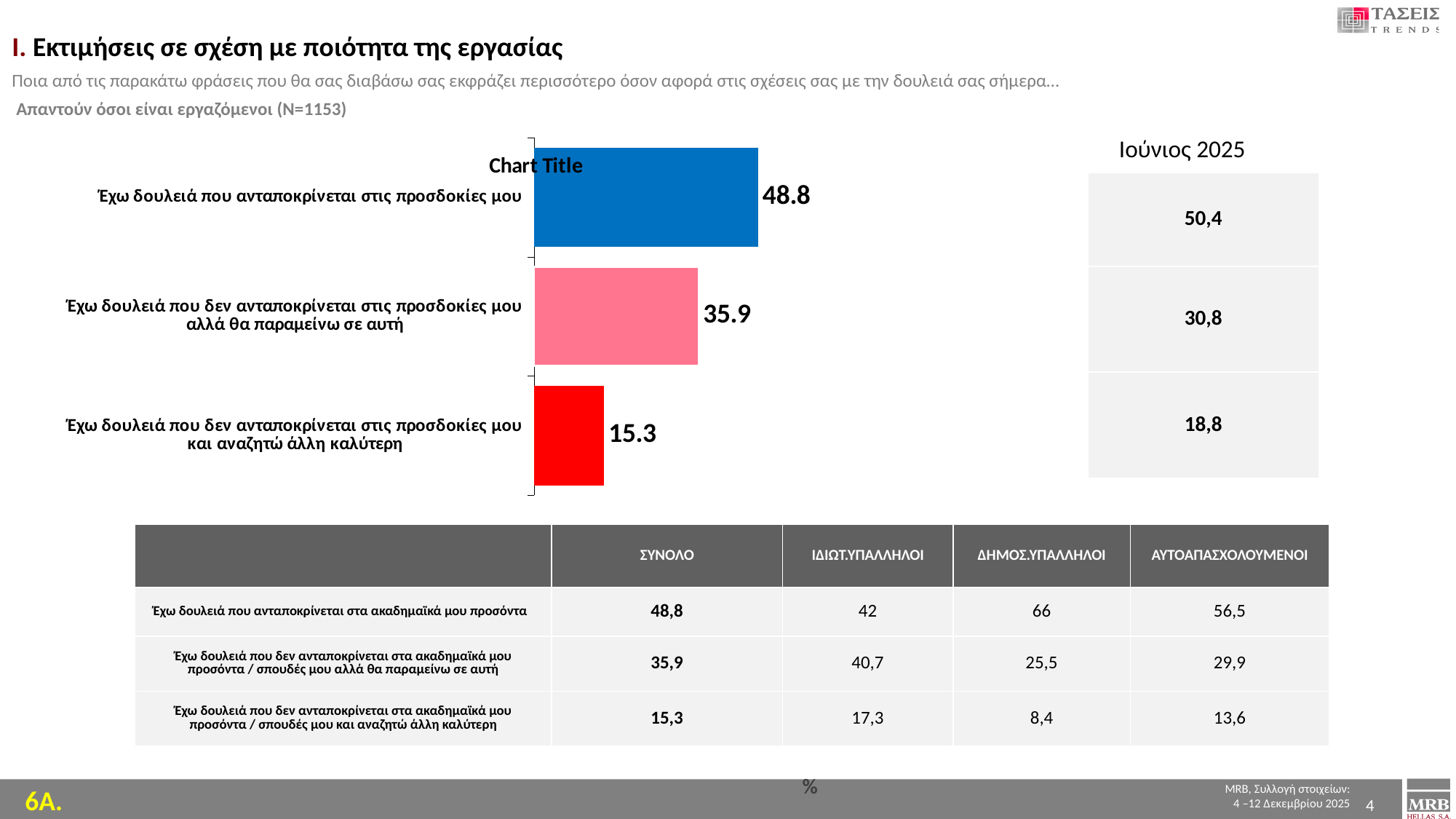
What is the difference between the value for "Έχω δουλειά που δεν ανταποκρίνεται στις προσδοκίες μου αλλά θα παραμείνω σε αυτή" and the value for "Έχω δουλειά που δεν ανταποκρίνεται στις προσδοκίες μου και αναζητώ άλλη καλύτερη"? 20.6 Which category has the highest value in the bar chart? Έχω δουλειά που ανταποκρίνεται στις προσδοκίες μου What kind of chart is shown on the slide? Bar chart What is the difference between the value for "Έχω δουλειά που ανταποκρίνεται στις προσδοκίες μου" and the value for "Έχω δουλειά που δεν ανταποκρίνεται στις προσδοκίες μου αλλά θα παραμείνω σε αυτή"? 12.9 Which is larger: the value for "Έχω δουλειά που δεν ανταποκρίνεται στις προσδοκίες μου αλλά θα παραμείνω σε αυτή" or the value for "Έχω δουλειά που δεν ανταποκρίνεται στις προσδοκίες μου και αναζητώ άλλη καλύτερη"? Έχω δουλειά που δεν ανταποκρίνεται στις προσδοκίες μου αλλά θα παραμείνω σε αυτή What value is shown for the bar labelled "Έχω δουλειά που ανταποκρίνεται στις προσδοκίες μου"? 48.8 What colour is the bar for "Έχω δουλειά που δεν ανταποκρίνεται στις προσδοκίες μου και αναζητώ άλλη καλύτερη"? Red What value is shown for the bar labelled "Έχω δουλειά που δεν ανταποκρίνεται στις προσδοκίες μου αλλά θα παραμείνω σε αυτή"? 35.9 What title text is displayed on the chart? Chart Title Which category has the lowest value in the bar chart? Έχω δουλειά που δεν ανταποκρίνεται στις προσδοκίες μου και αναζητώ άλλη καλύτερη How many bars are plotted in the chart? 3 What value is shown for the bar labelled "Έχω δουλειά που δεν ανταποκρίνεται στις προσδοκίες μου και αναζητώ άλλη καλύτερη"? 15.3